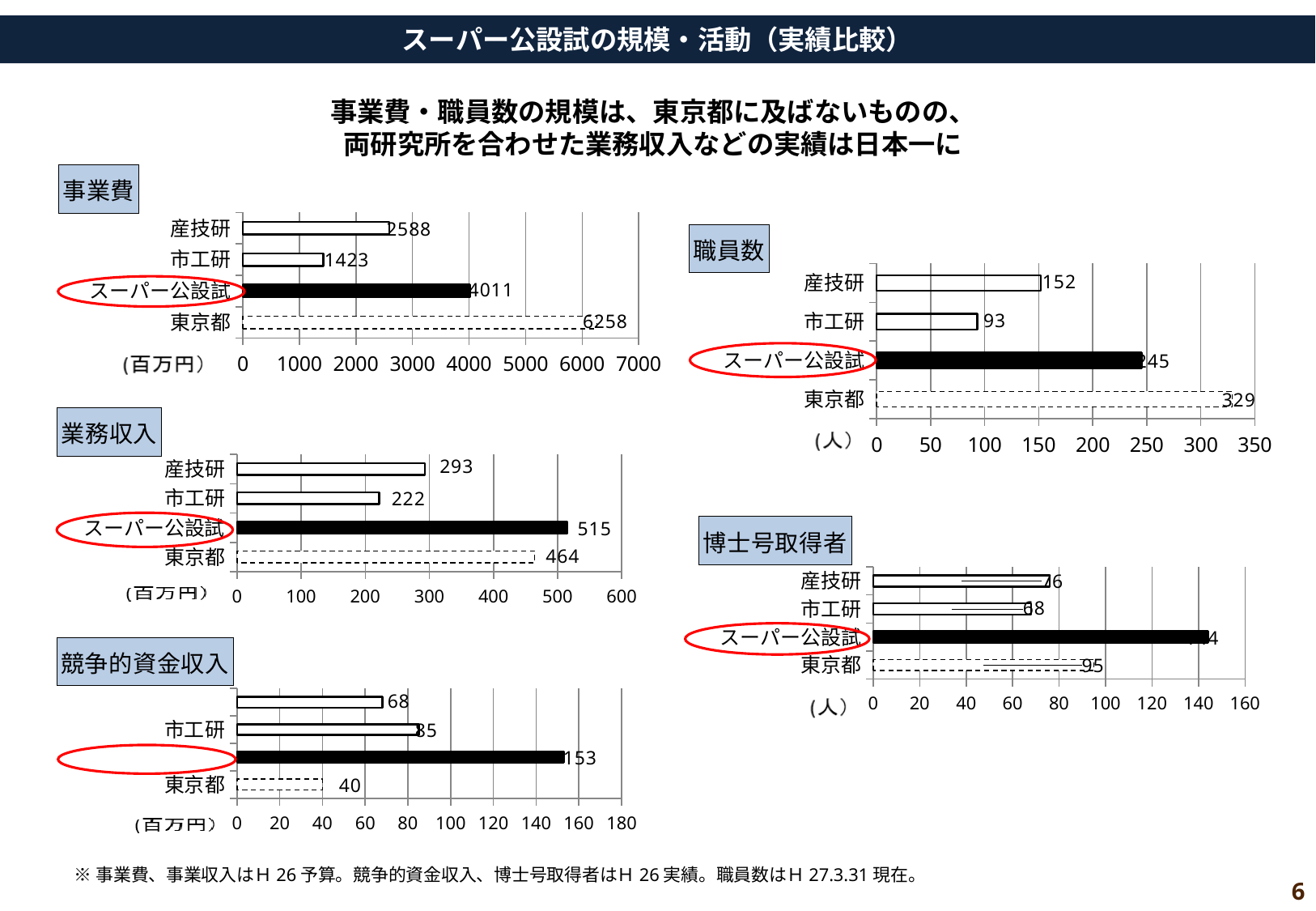
In the 職員数 chart, is the value for 東京都 greater or less than 300? greater In the 博士号取得者 chart, what is the value for 東京都? 95 In the 事業費 chart, what is the difference between the values for 東京都 and スーパー公設試? 2247 In the 事業費 chart, which category has the highest value? 東京都 In the 職員数 chart, what is the value for 産技研? 152 In the 競争的資金収入 chart, which labelled category has the lowest value? 東京都 In the 業務収入 chart, what is the difference between the values for スーパー公設試 and 東京都? 51 In the 業務収入 chart, what is the value for スーパー公設試? 515 What kind of chart is the 事業費 chart? bar chart In the 業務収入 chart, which category has the highest value? スーパー公設試 In the 事業費 chart, what is the value for 東京都? 6258 In the 競争的資金収入 chart, what is the value for 東京都? 40